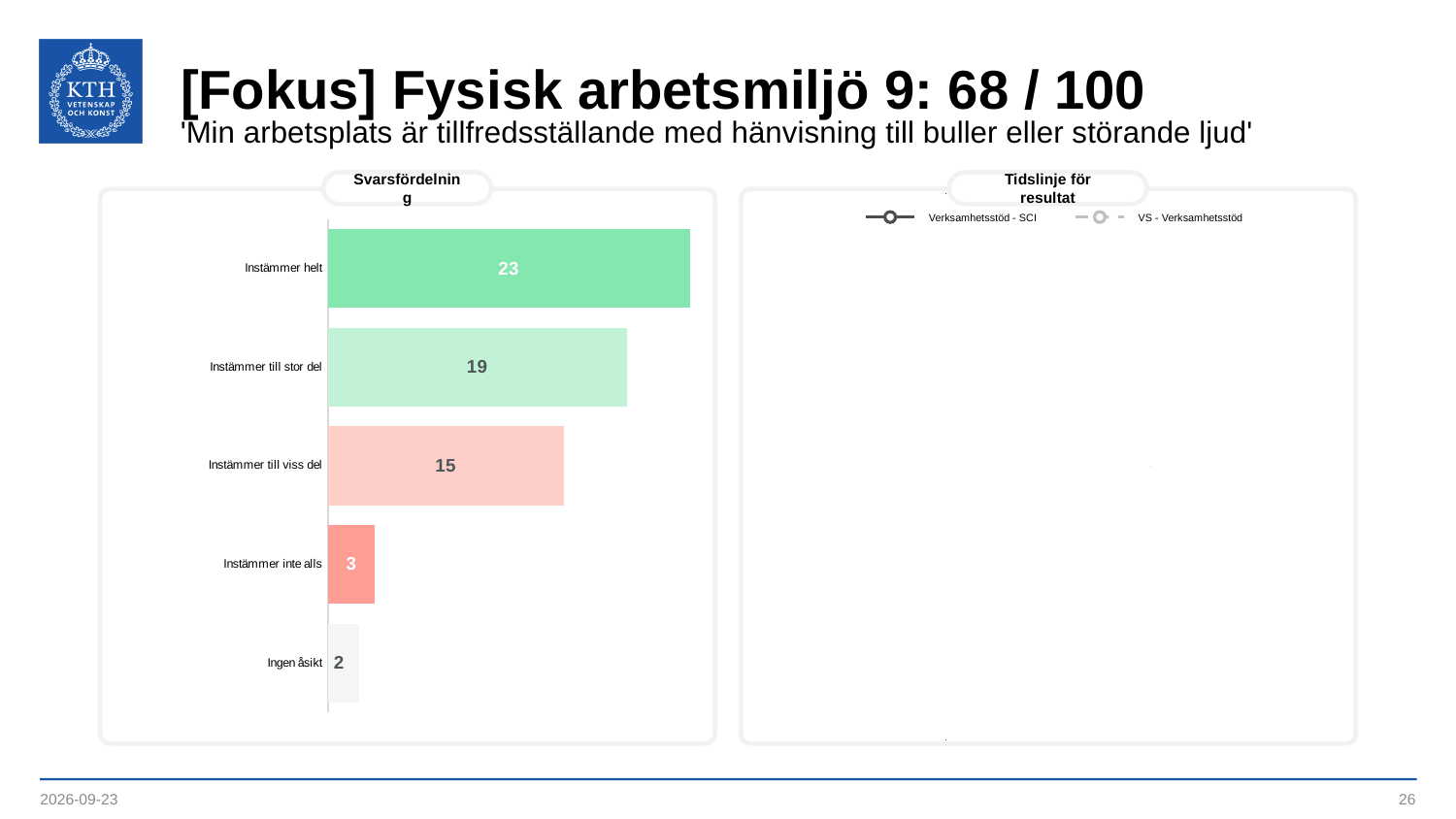
How many series does the legend of the 'Tidslinje för resultat' chart list? 2 In the 'Svarsfördelning' chart, which category has the highest value? Instämmer helt In the 'Svarsfördelning' chart, what is the value for 'Ingen åsikt'? 2 What kind of chart is the 'Svarsfördelning' chart? Bar chart In the 'Svarsfördelning' chart, what is the value for 'Instämmer till stor del'? 19 In the 'Svarsfördelning' chart, which is larger: 'Instämmer till stor del' or 'Instämmer inte alls'? Instämmer till stor del In the 'Svarsfördelning' chart, what is the value for 'Instämmer till viss del'? 15 In the 'Svarsfördelning' chart, which category has the lowest value? Ingen åsikt In the 'Svarsfördelning' chart, what is the total of all five category values? 62 How many categories are shown in the 'Svarsfördelning' chart? 5 In the 'Svarsfördelning' chart, what is the difference between 'Instämmer helt' and 'Instämmer till viss del'? 8 In the 'Svarsfördelning' chart, what is the value for 'Instämmer helt'? 23